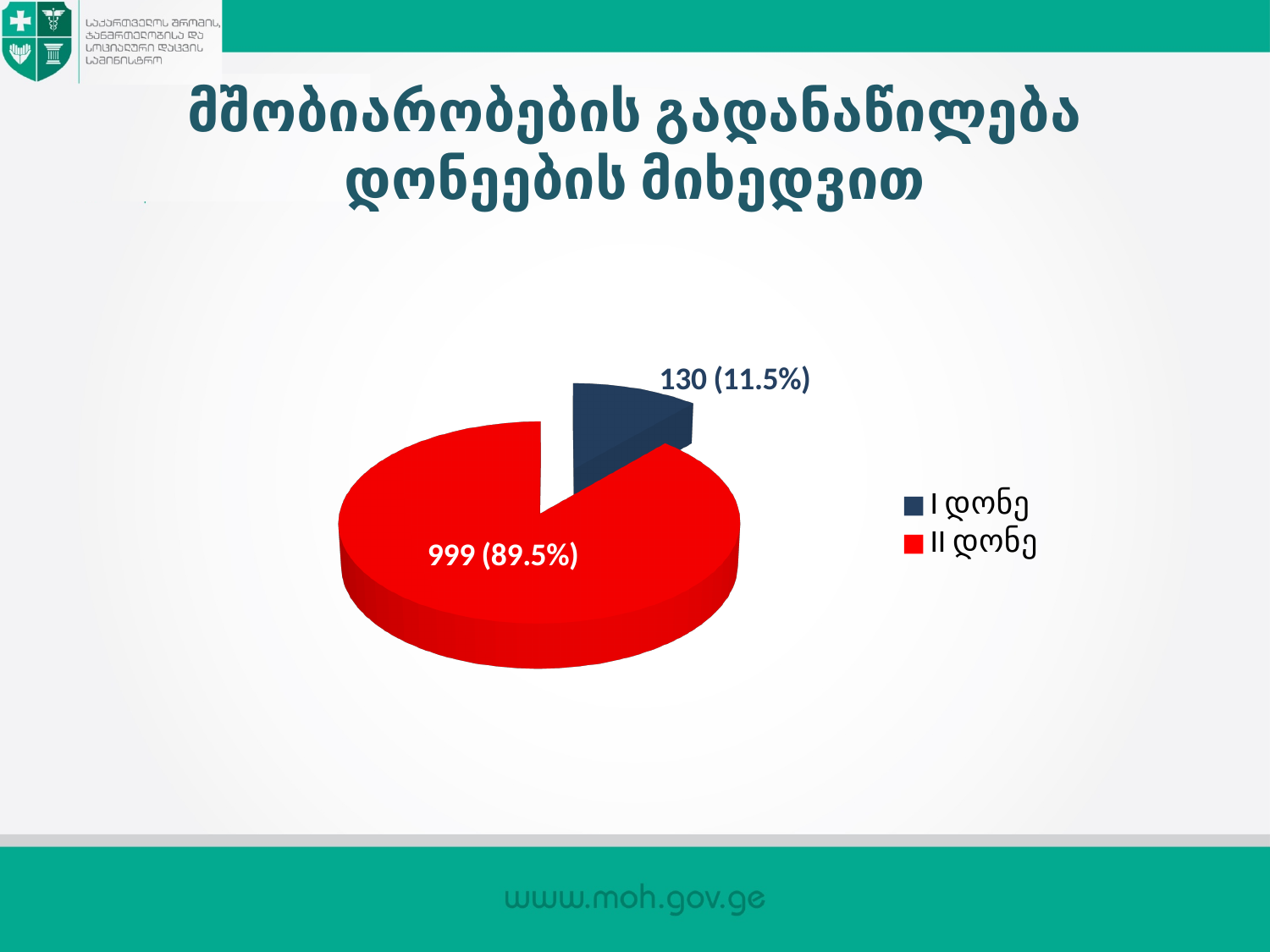
Which is larger, the value for I დონე or II დონე? II დონე How many entries does the legend list? 2 Which category has the largest slice of the pie? II დონე What is the value for II დონე? 999 What percentage share is shown for I დონე? 11.5% What is the value for I დონე? 130 What is the difference between the values for II დონე and I დონე? 869 How many slices does the pie chart have? 2 What percentage share is shown for II დონე? 89.5% What kind of chart is shown on the slide? pie chart Which category has the smallest slice of the pie? I დონე What colour is the slice for II დონე? red